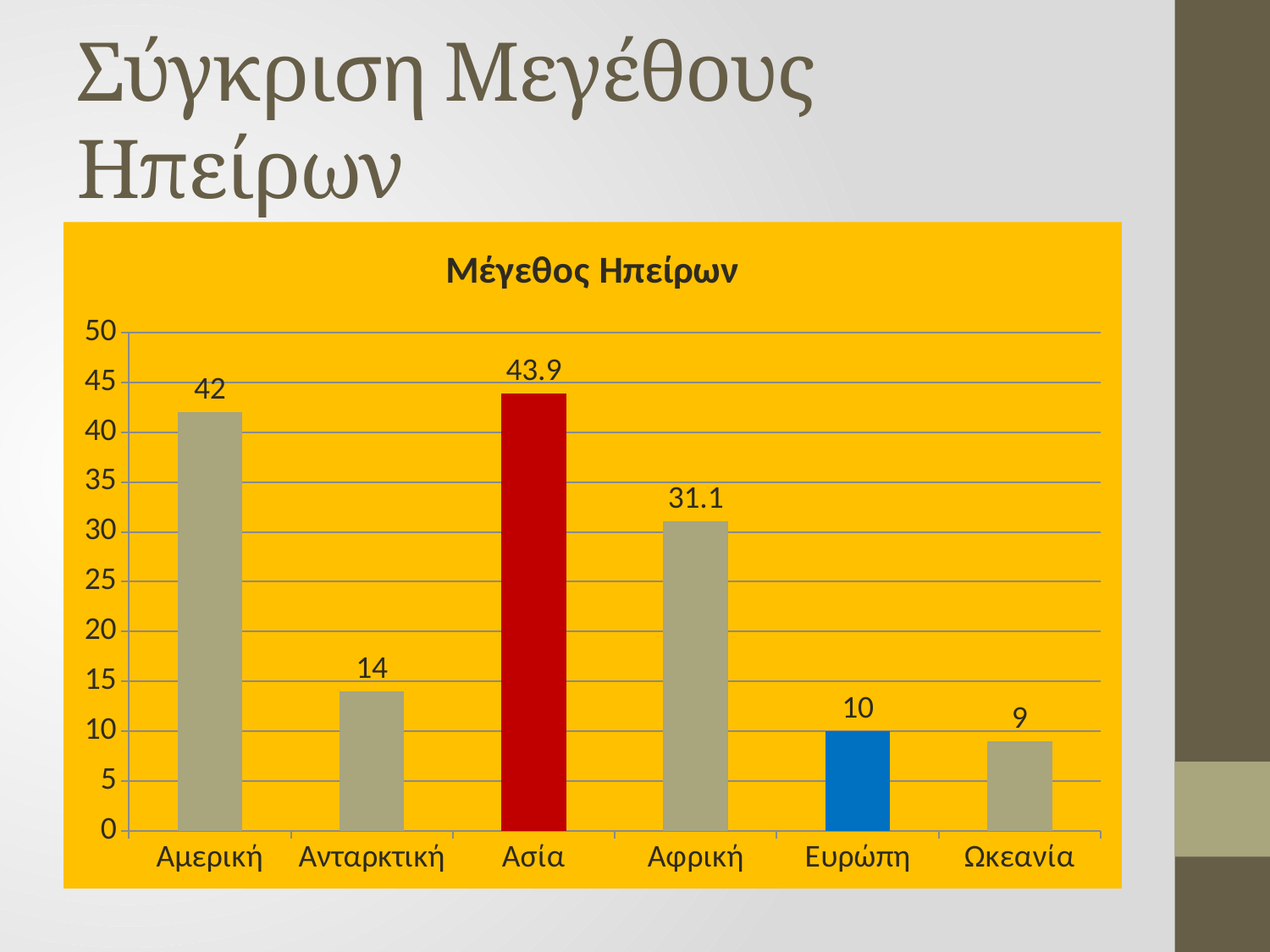
What is the value for Αφρική in the chart? 31.1 Which is larger, the value for Ευρώπη or the value for Ανταρκτική? Ανταρκτική What is the value for Ανταρκτική in the chart? 14 Which category has the lowest value in the chart? Ωκεανία Is the value for Αφρική greater or less than 30? greater What is the value for Ασία in the chart? 43.9 Which category's bar is coloured red? Ασία What is the difference between the values for Αμερική and Αφρική? 10.9 What kind of chart is shown on the slide? Bar chart Which category has the highest value in the chart? Ασία How many categories are shown in the chart? 6 What is the title of the chart? Μέγεθος Ηπείρων